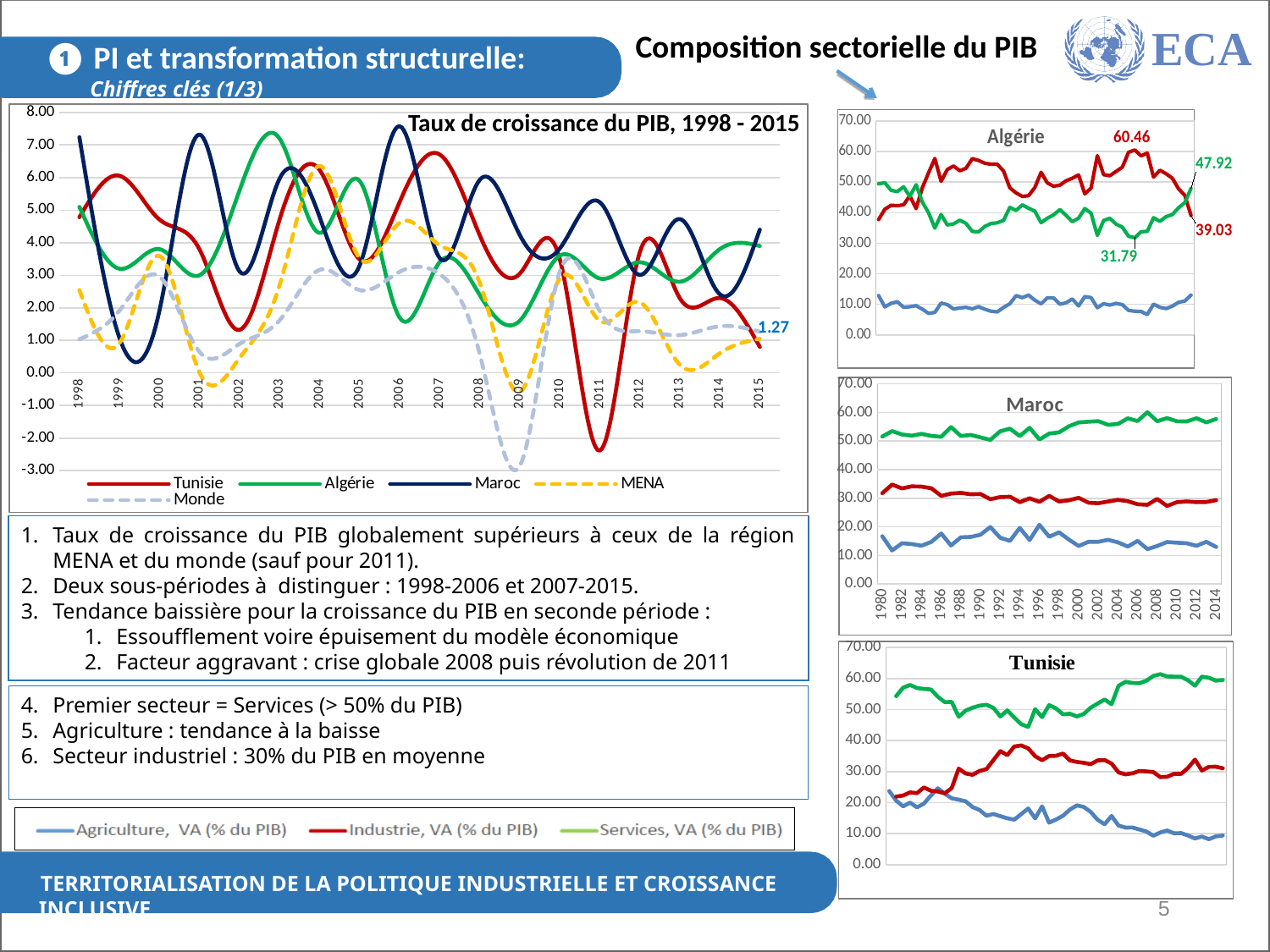
In the Algérie chart, what is the labeled final value of the Services series? 47.92 In the Algérie chart, what is the difference between the labeled peak of Industrie (60.46) and its labeled final value (39.03)? 21.43 How many series does the legend of the 'Taux de croissance du PIB, 1998 - 2015' chart list? 5 In the Maroc chart, is the value of the Agriculture series in 2014 greater or less than 30? less In the Tunisie chart, does the Agriculture series rise or fall over the period shown? fall In the 'Taux de croissance du PIB, 1998 - 2015' chart, which series has the lowest value in 2011? Tunisie In the Algérie chart, what is the lowest labeled value of the Services series? 31.79 In the Algérie chart, which is larger at the end of the series: Services (47.92) or Industrie (39.03)? Services In the Algérie chart, what is the highest labeled value of the Industrie series? 60.46 How many series does the legend for the sectoral composition charts (Algérie, Maroc, Tunisie) list? 3 In the Tunisie chart, is the value of the Services series at the end of the period greater or less than 50? greater What kind of chart is the 'Taux de croissance du PIB, 1998 - 2015' chart? line chart